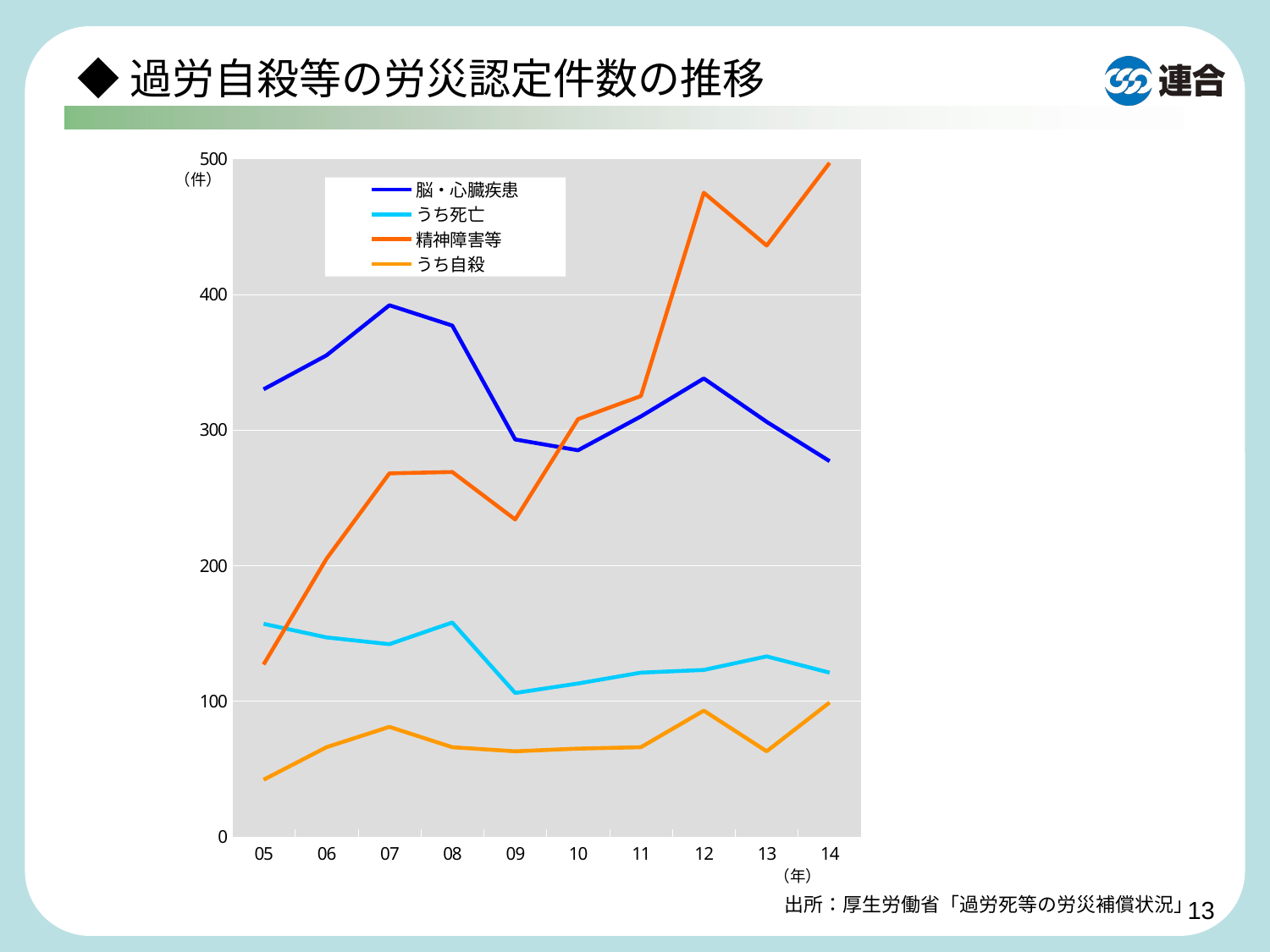
Does 精神障害等 generally rise or fall from 05 to 14? rise In which year is 精神障害等 at its lowest? 05 How many years are plotted along the x axis? 10 Is the value for うち自殺 in 13 greater or less than 100? less In which year is 精神障害等 at its highest? 14 Is the value for 精神障害等 in 14 greater or less than 400? greater Is the value for 脳・心臓疾患 in 14 greater or less than 300? less In which year is 脳・心臓疾患 at its highest? 07 Which series reaches the highest value on the chart? 精神障害等 How many series does the legend list? 4 What kind of chart is shown on the slide? line chart In 05, which is larger: 脳・心臓疾患 or 精神障害等? 脳・心臓疾患